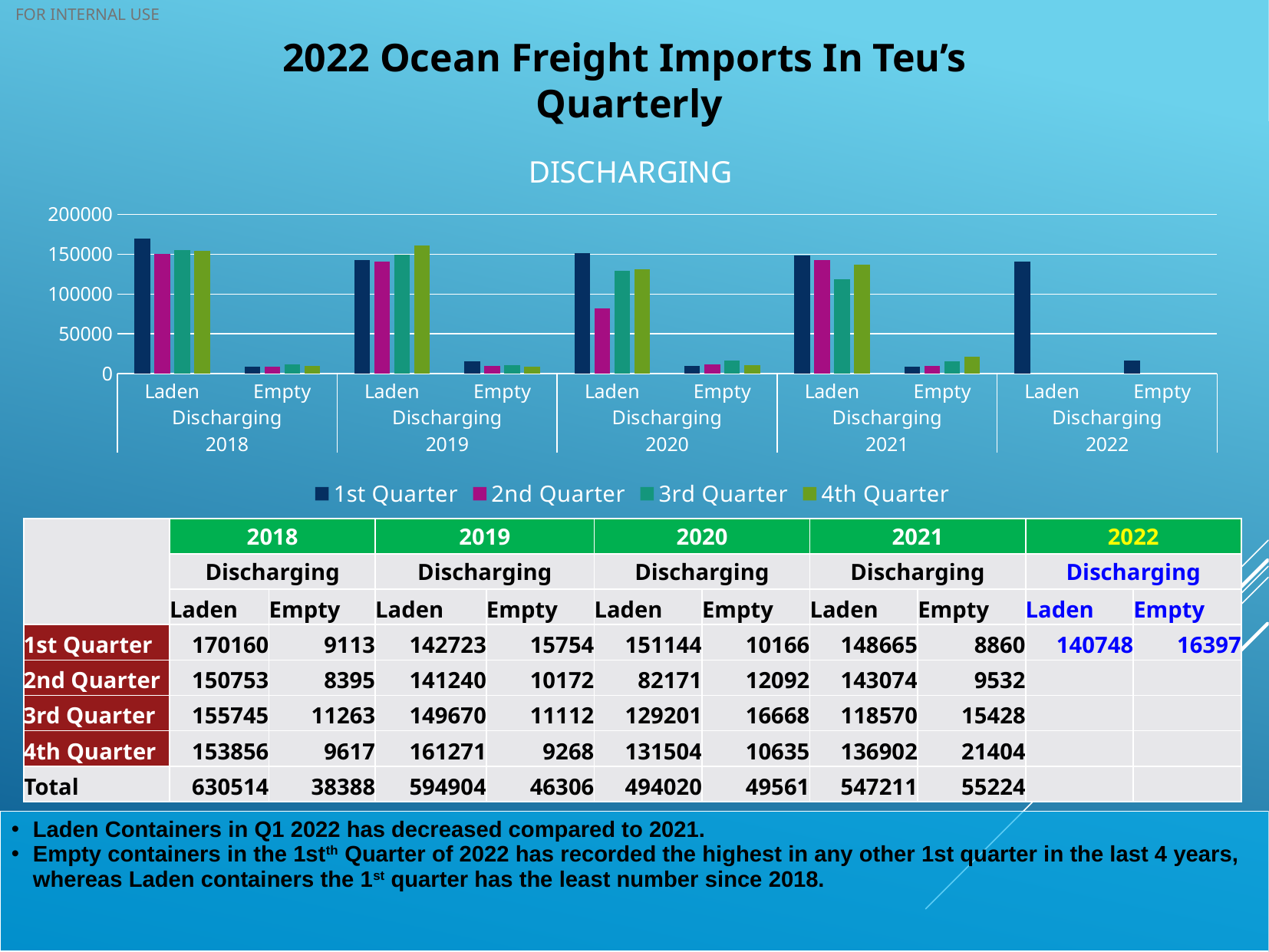
Is the 1st Quarter Laden Discharging value for 2022 greater or less than 100000? greater What type of chart is shown on the slide? bar chart What is the 4th Quarter value for Empty Discharging in 2021? 21404 What is the difference between the 1st Quarter Laden Discharging values for 2021 and 2022? 7917 How many series does the chart legend list? 4 Which is larger, the 4th Quarter Laden Discharging value for 2018 or for 2019? 2019 Which year has the lowest 2nd Quarter Laden Discharging value? 2020 Is the 2nd Quarter Laden Discharging value for 2020 greater or less than 100000? less What is the 1st Quarter value for Laden Discharging in 2018? 170160 What is the title of the chart? DISCHARGING How many years are shown along the x axis of the chart? 5 Which year has the highest 1st Quarter Laden Discharging value? 2018